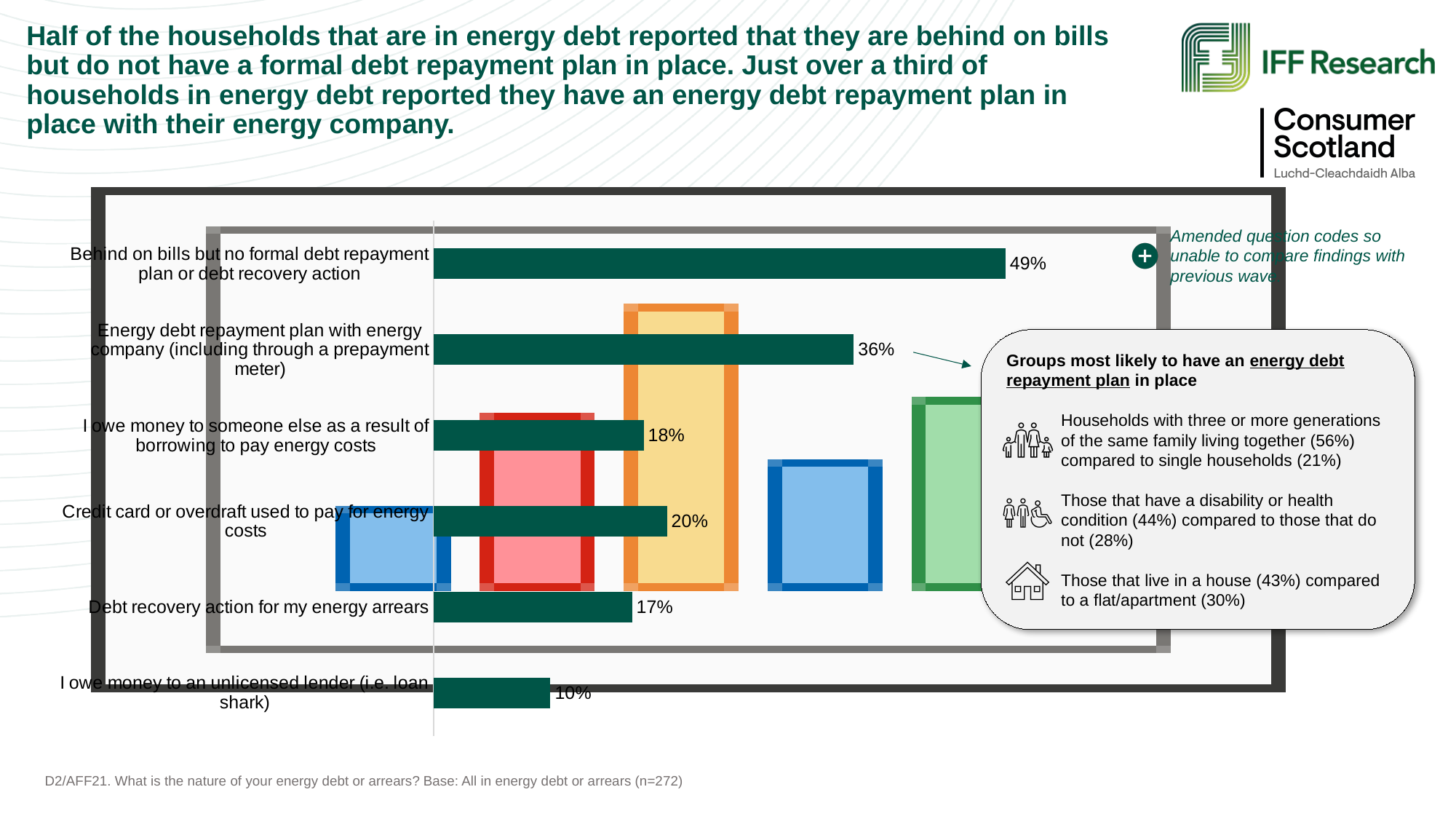
What percentage reported using a credit card or overdraft to pay for energy costs? 20% Which is larger: the value for 'Credit card or overdraft used to pay for energy costs' or the value for 'Debt recovery action for my energy arrears'? Credit card or overdraft used to pay for energy costs What percentage reported owing money to an unlicensed lender (i.e. loan shark)? 10% What percentage reported having an energy debt repayment plan with their energy company (including through a prepayment meter)? 36% What is the difference between the value for 'Behind on bills but no formal debt repayment plan or debt recovery action' and the value for 'Energy debt repayment plan with energy company'? 13 percentage points How many categories are shown in the bar chart? 6 According to the call-out box, what percentage of households with three or more generations of the same family living together have an energy debt repayment plan in place? 56% Which category has the lowest value in the chart? I owe money to an unlicensed lender (i.e. loan shark) What percentage of households in energy debt reported being behind on bills but with no formal debt repayment plan or debt recovery action? 49% What type of chart is shown on the slide? Bar chart Which category has the highest value in the chart? Behind on bills but no formal debt repayment plan or debt recovery action What is the difference between the value for 'I owe money to someone else as a result of borrowing to pay energy costs' and the value for 'Debt recovery action for my energy arrears'? 1 percentage point